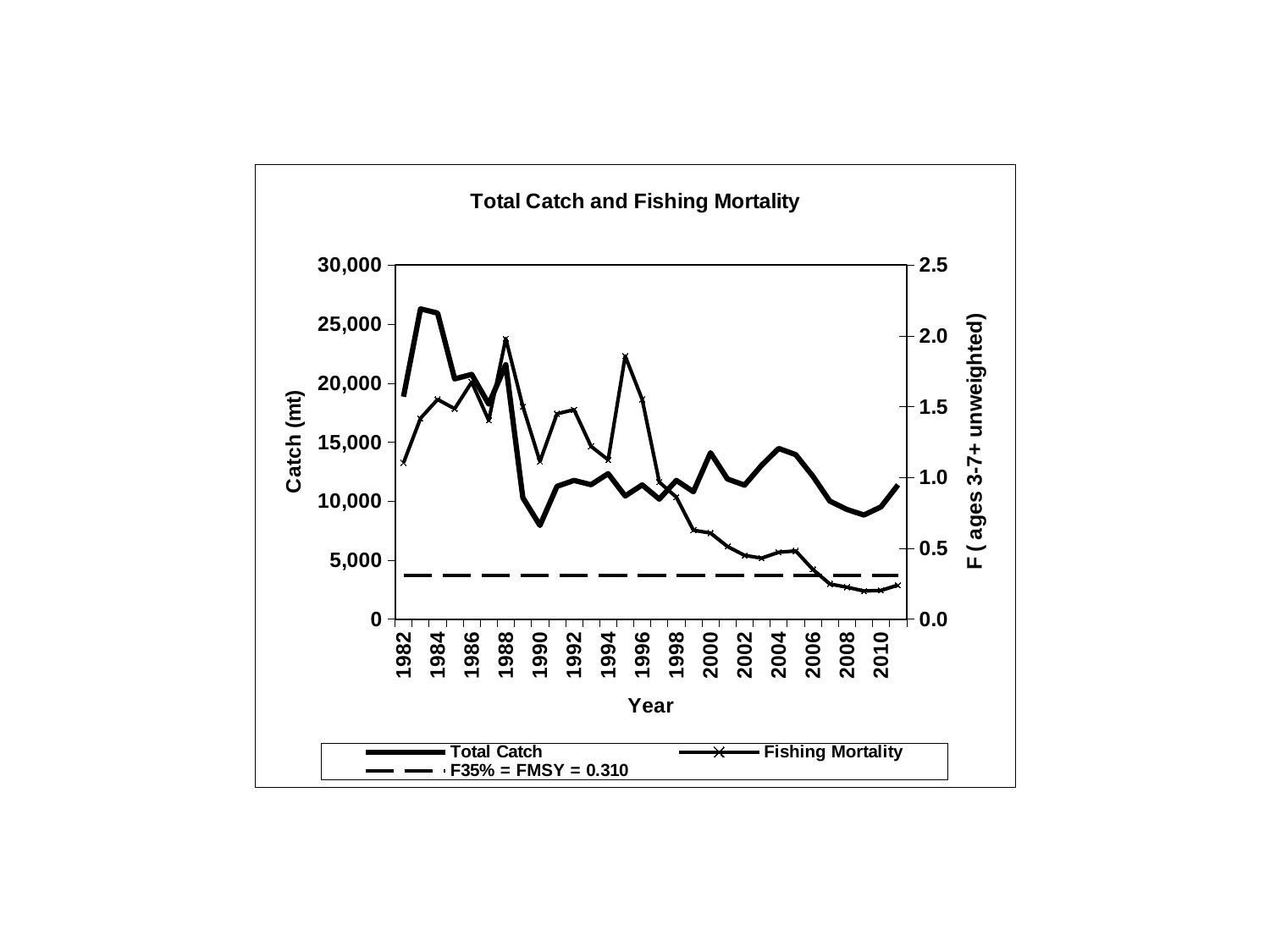
Does Fishing Mortality generally rise or fall from 1982 to 2011? fall Is the Fishing Mortality value for 2011 greater or less than 0.5? less What is the title of the chart? Total Catch and Fishing Mortality Is the Fishing Mortality value for 1988 greater or less than 1.5? greater What is the label of the right-hand y axis? F ( ages 3-7+ unweighted) What value does the dashed F35% = FMSY reference line represent? 0.310 How many series does the legend list? 3 In which year is Total Catch highest? 1983 Is the Total Catch value for 1990 greater or less than 10,000? less What kind of chart is shown on the slide? Line chart Which is larger, the Fishing Mortality value in 1995 or in 2005? 1995